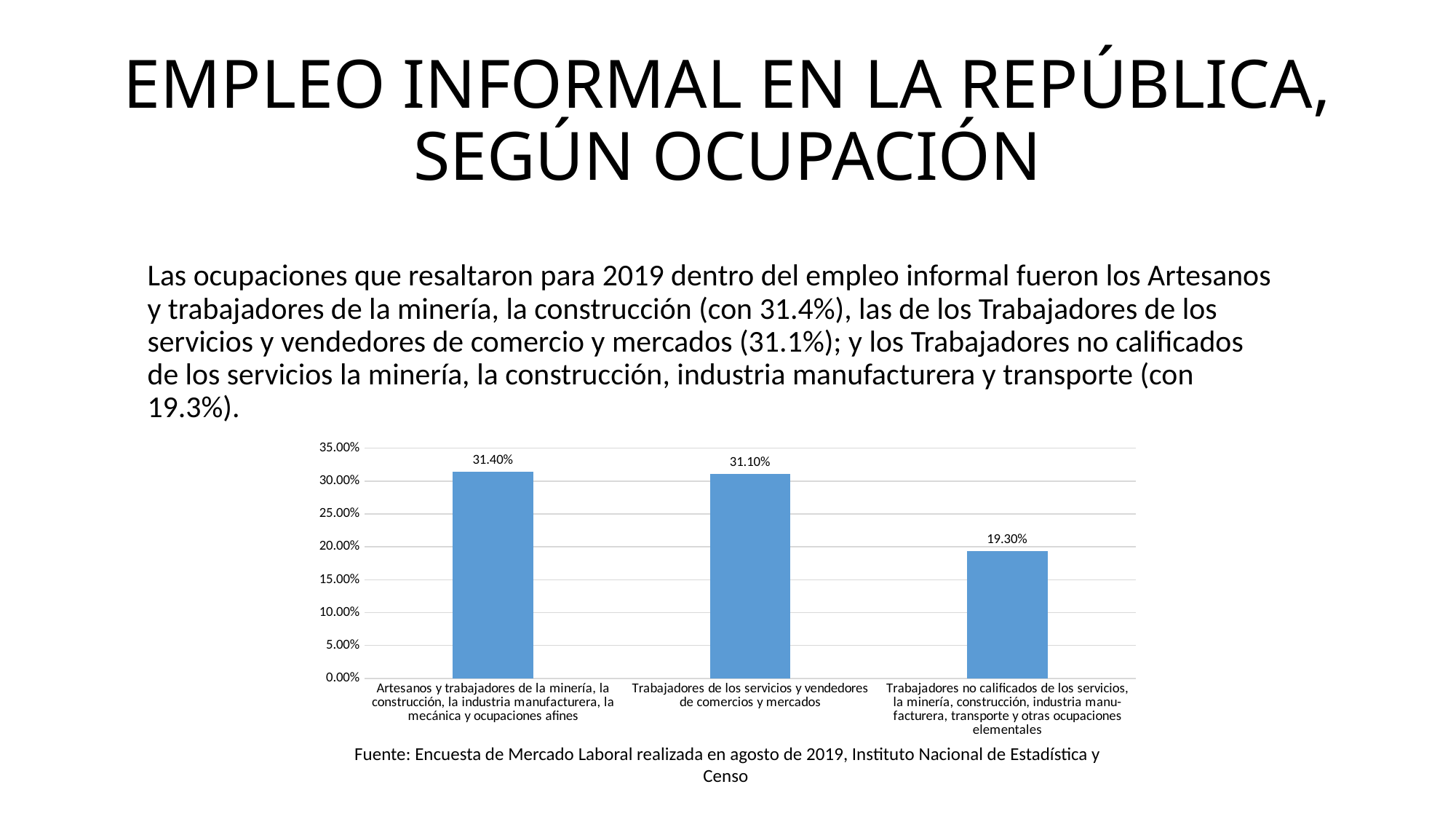
Which is larger: the value for Trabajadores de los servicios y vendedores de comercios y mercados or the value for Trabajadores no calificados de los servicios? Trabajadores de los servicios y vendedores de comercios y mercados Which occupation category has the highest value in the chart? Artesanos y trabajadores de la minería, la construcción, la industria manufacturera, la mecánica y ocupaciones afines What is the value for Artesanos y trabajadores de la minería, la construcción, la industria manufacturera, la mecánica y ocupaciones afines? 31.40% What is the value for Trabajadores no calificados de los servicios, la minería, construcción, industria manufacturera, transporte y otras ocupaciones elementales? 19.30% What is the difference between the value for Artesanos y trabajadores de la minería and the value for Trabajadores de los servicios y vendedores de comercios y mercados? 0.30 percentage points What is the difference between the value for Artesanos y trabajadores de la minería and the value for Trabajadores no calificados de los servicios? 12.10 percentage points Do the values rise or fall from left to right across the categories? Fall Is the value for Trabajadores no calificados de los servicios greater or less than 20.00%? less Which occupation category has the lowest value in the chart? Trabajadores no calificados de los servicios, la minería, construcción, industria manufacturera, transporte y otras ocupaciones elementales What kind of chart is shown on the slide? Bar chart How many occupation categories are shown in the chart? 3 What is the value for Trabajadores de los servicios y vendedores de comercios y mercados? 31.10%